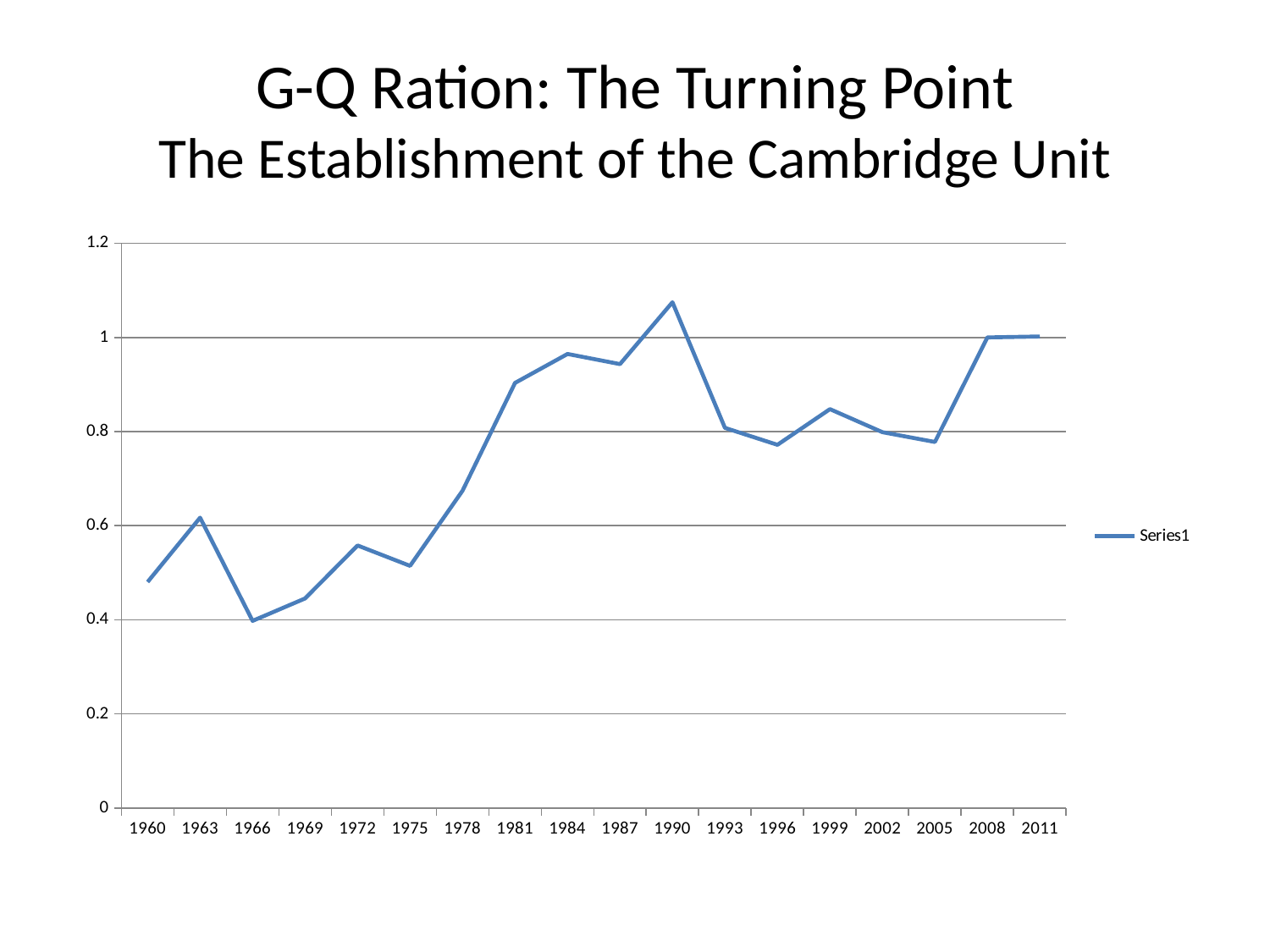
Which year has the larger value, 1990 or 1993? 1990 How many years are labelled along the x axis? 18 Is the value for 1960 greater or less than 0.6? less What kind of chart is shown on the slide? line chart Which year has the larger value, 1963 or 1966? 1963 How many series does the legend list? 1 Does the line rise or fall between 1990 and 1996? fall In which year does the line reach its lowest value? 1966 What is the name of the series shown in the legend? Series1 Is the value for 1990 greater or less than 1? greater In which year does the line reach its highest value? 1990 Is the value for 1981 greater or less than 0.8? greater